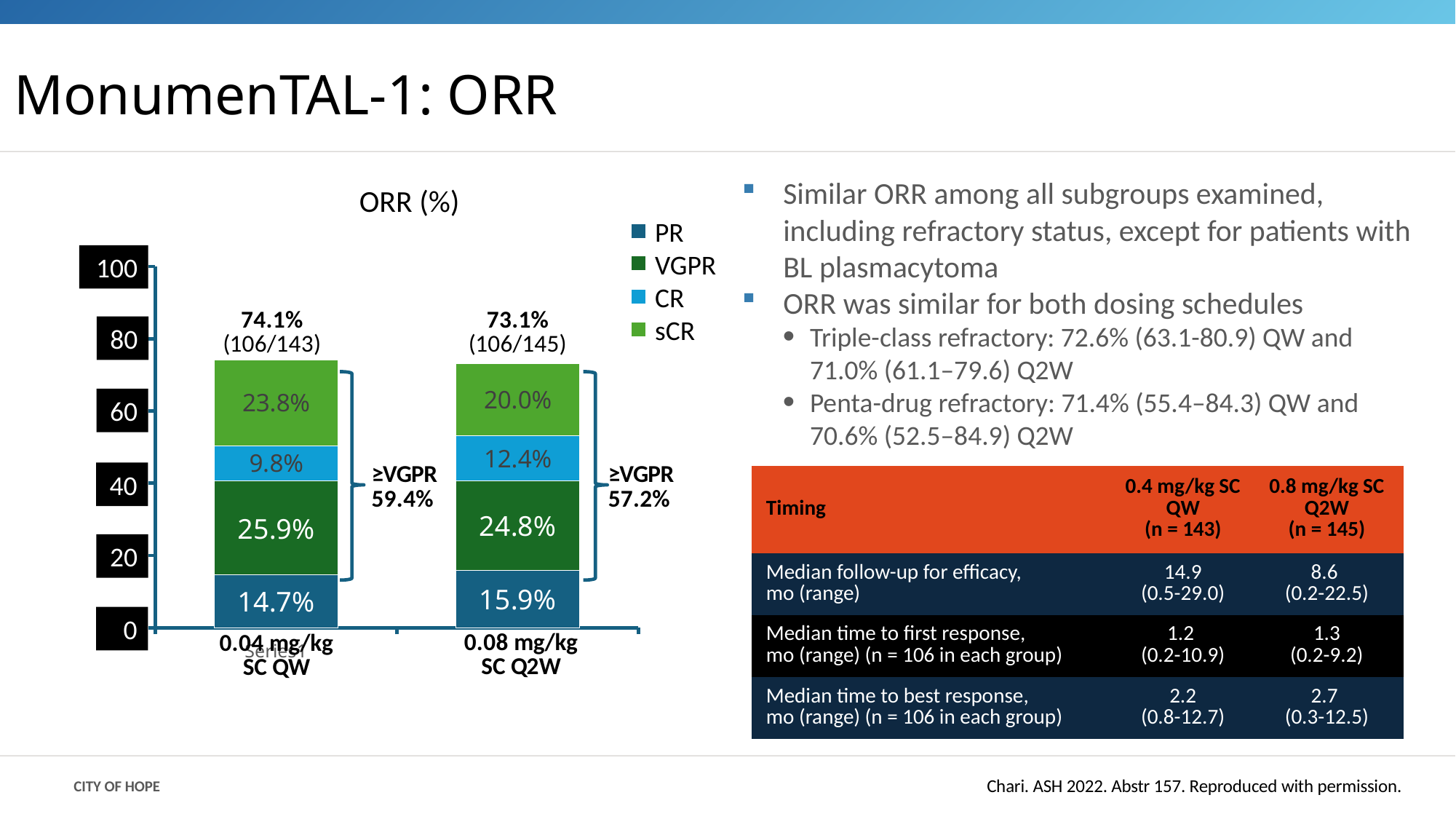
What is the difference between the CR values of the 0.08 mg/kg SC Q2W group and the 0.04 mg/kg SC QW group? 2.6% What is the total ORR shown above the 0.04 mg/kg SC QW bar? 74.1% How many dosing groups (bars) are plotted in the chart? 2 Which group has the larger sCR value, 0.04 mg/kg SC QW or 0.08 mg/kg SC Q2W? 0.04 mg/kg SC QW What is the total ORR shown above the 0.08 mg/kg SC Q2W bar? 73.1% What is the title of the chart? ORR (%) What is the sCR value for the 0.08 mg/kg SC Q2W group? 20.0% How many series does the chart legend list? 4 What is the PR value for the 0.04 mg/kg SC QW group? 14.7% What is the VGPR value for the 0.08 mg/kg SC Q2W group? 24.8% What is the CR value for the 0.04 mg/kg SC QW group? 9.8% What type of chart is shown on the slide? Stacked bar chart